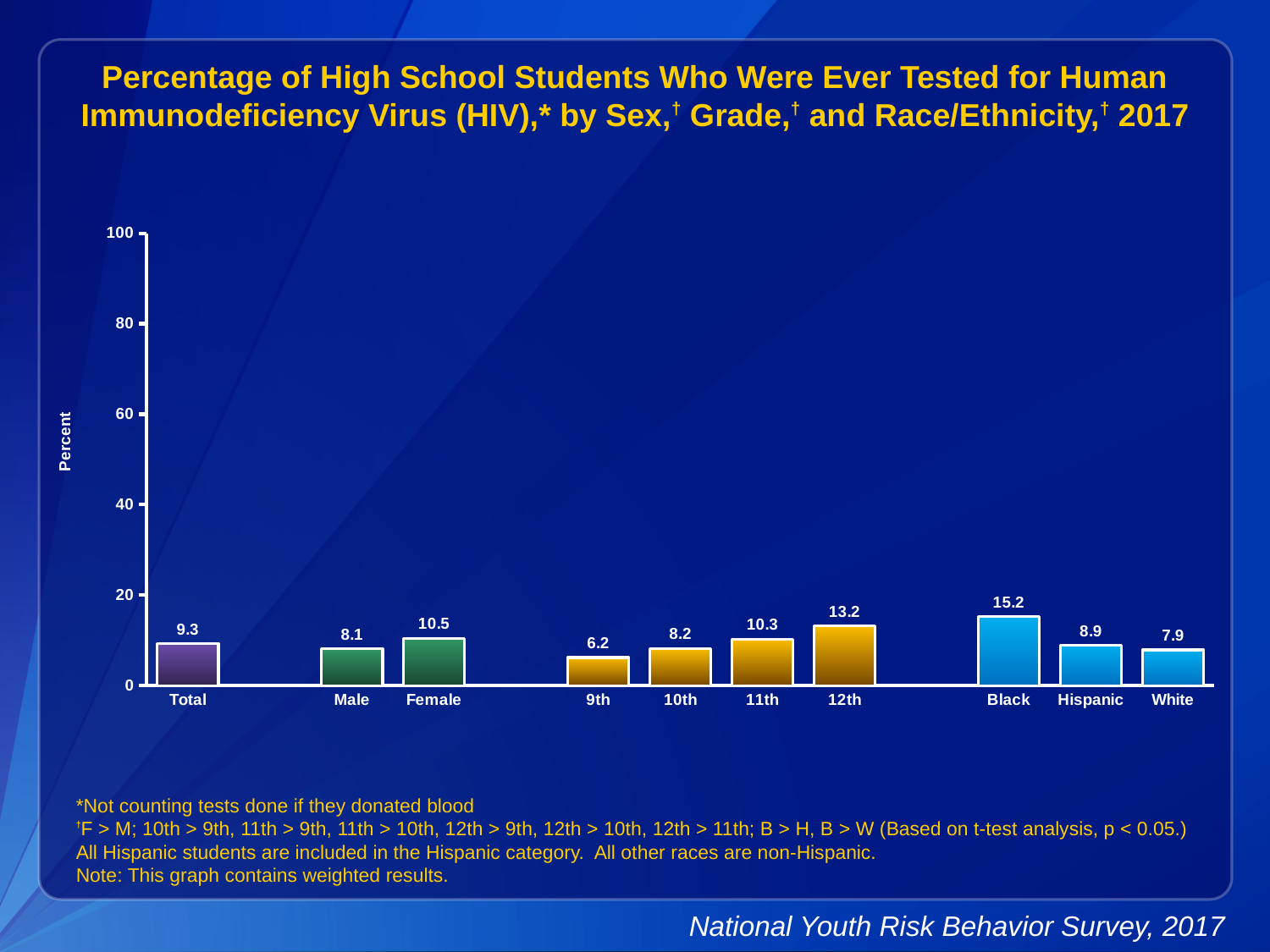
Which category has the highest value? Black What is the value for 12th grade? 13.2 How many categories are shown on the x axis? 10 Do the values rise or fall from 9th grade to 12th grade? rise What is the value for Hispanic? 8.9 Is the value for Black greater or less than 20? less What is the value for Total? 9.3 What is the difference between the values for Black and White? 7.3 Which category has the lowest value? 9th What is the difference between the values for Female and Male? 2.4 Which is larger, the value for 11th grade or the value for 10th grade? 11th What is the value for Female? 10.5